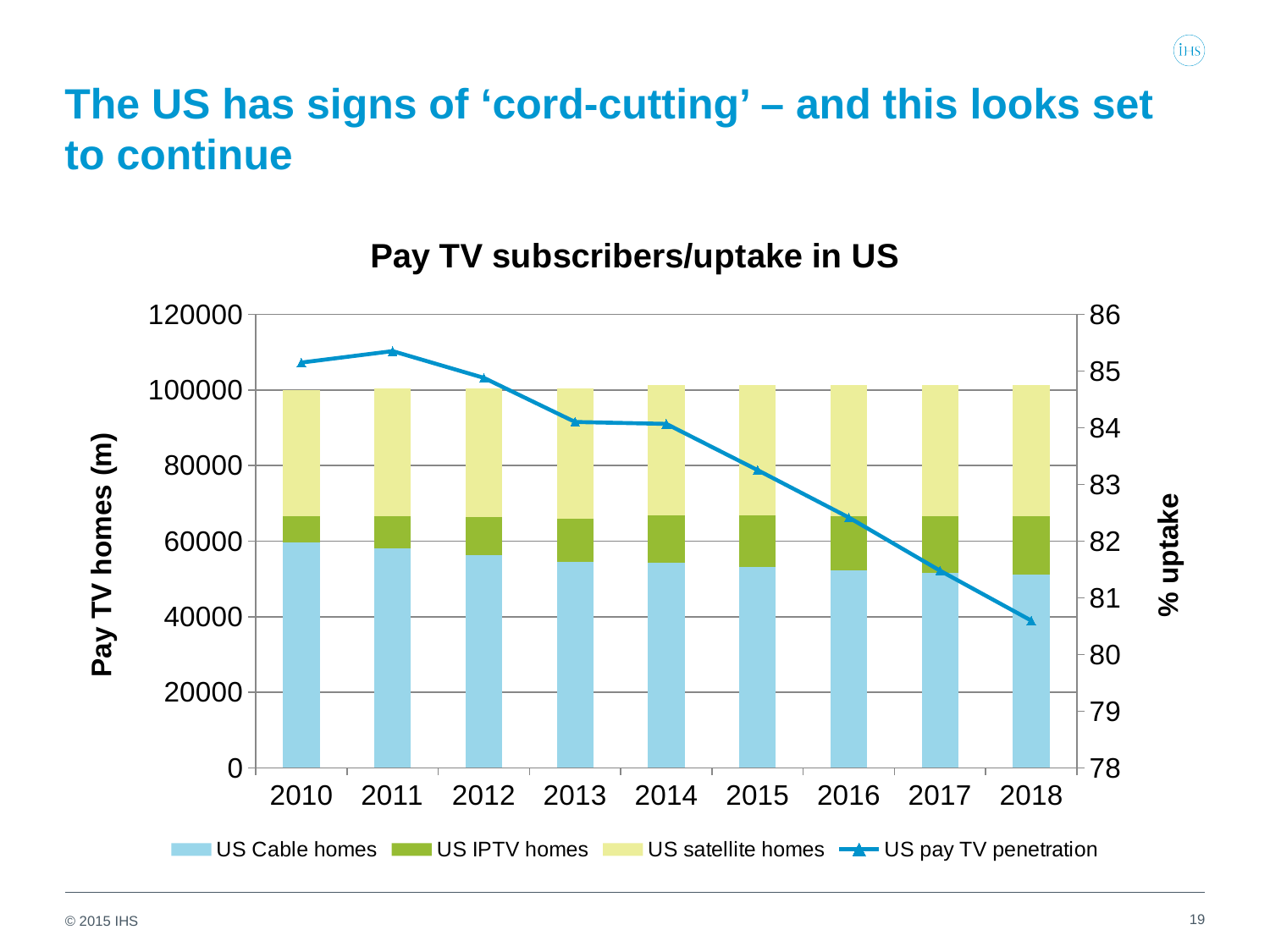
In 2014, which is larger: US satellite homes or US IPTV homes? US satellite homes What is the title of the chart? Pay TV subscribers/uptake in US In which year is US pay TV penetration lowest? 2018 How many years are shown on the x axis? 9 How many series does the legend list? 4 Does US pay TV penetration rise or fall between 2011 and 2018? Fall Which is larger: US Cable homes in 2010 or US Cable homes in 2018? 2010 Is US pay TV penetration in 2016 greater or less than 83? less Is the value for US Cable homes in 2010 greater or less than 40000? greater Is US pay TV penetration in 2011 greater or less than 85? greater In which year is US pay TV penetration highest? 2011 What kind of chart is shown on the slide? Stacked bar chart with a line